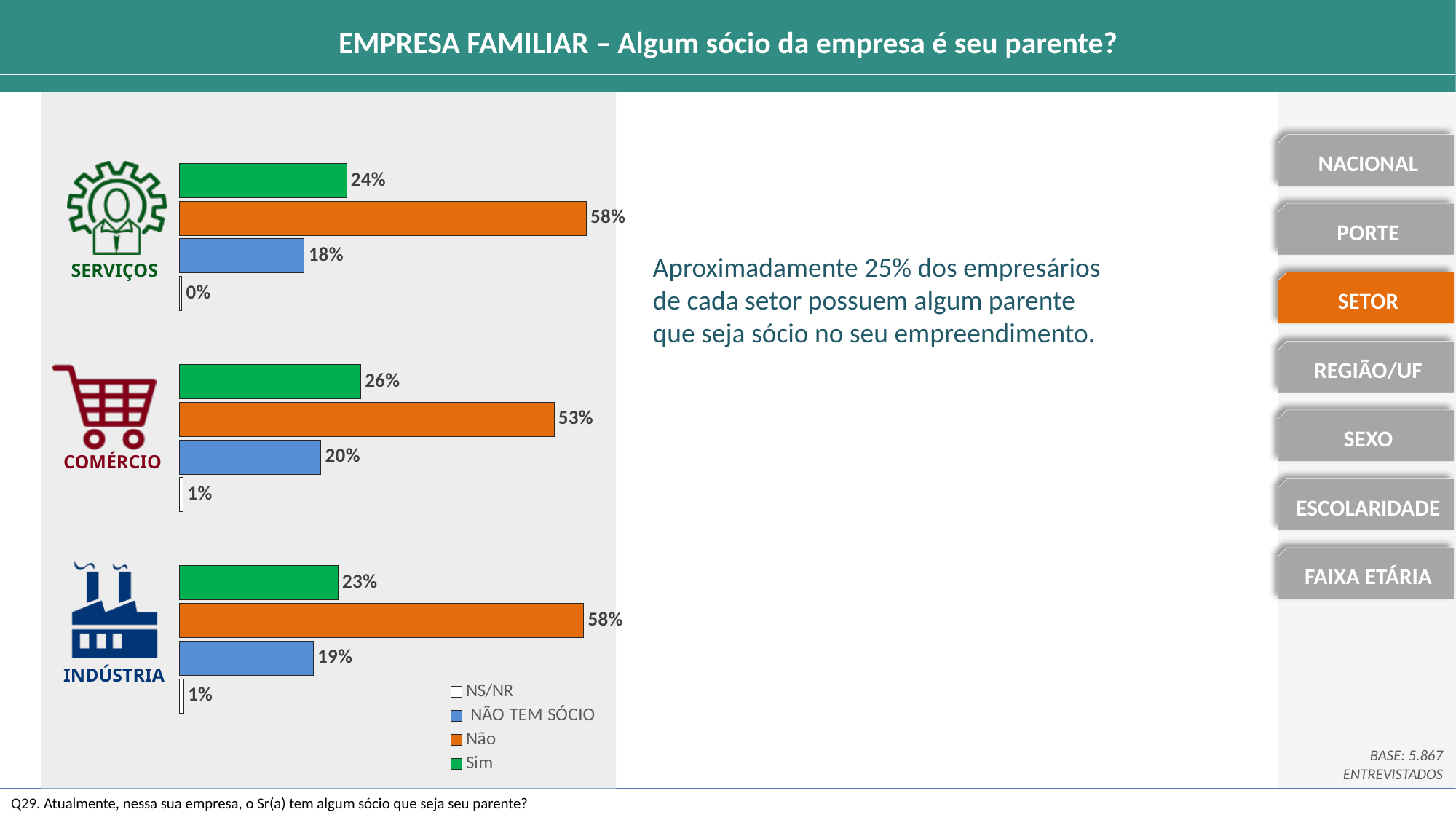
What kind of chart is shown on the slide? Bar chart How many sector categories are shown in the chart? 3 What is the value of "NS/NR" for SERVIÇOS? 0% What is the value of "NÃO TEM SÓCIO" for INDÚSTRIA? 19% What is the value of "Sim" for SERVIÇOS? 24% Which is larger: "NÃO TEM SÓCIO" for COMÉRCIO or "NÃO TEM SÓCIO" for SERVIÇOS? COMÉRCIO What is the value of "Não" for COMÉRCIO? 53% Which sector has the highest value for "Sim"? COMÉRCIO What is the difference between "Não" and "Sim" for INDÚSTRIA? 35% How many series does the legend list? 4 Which legend entry is shown in orange? Não Which sector has the lowest value for "Não"? COMÉRCIO